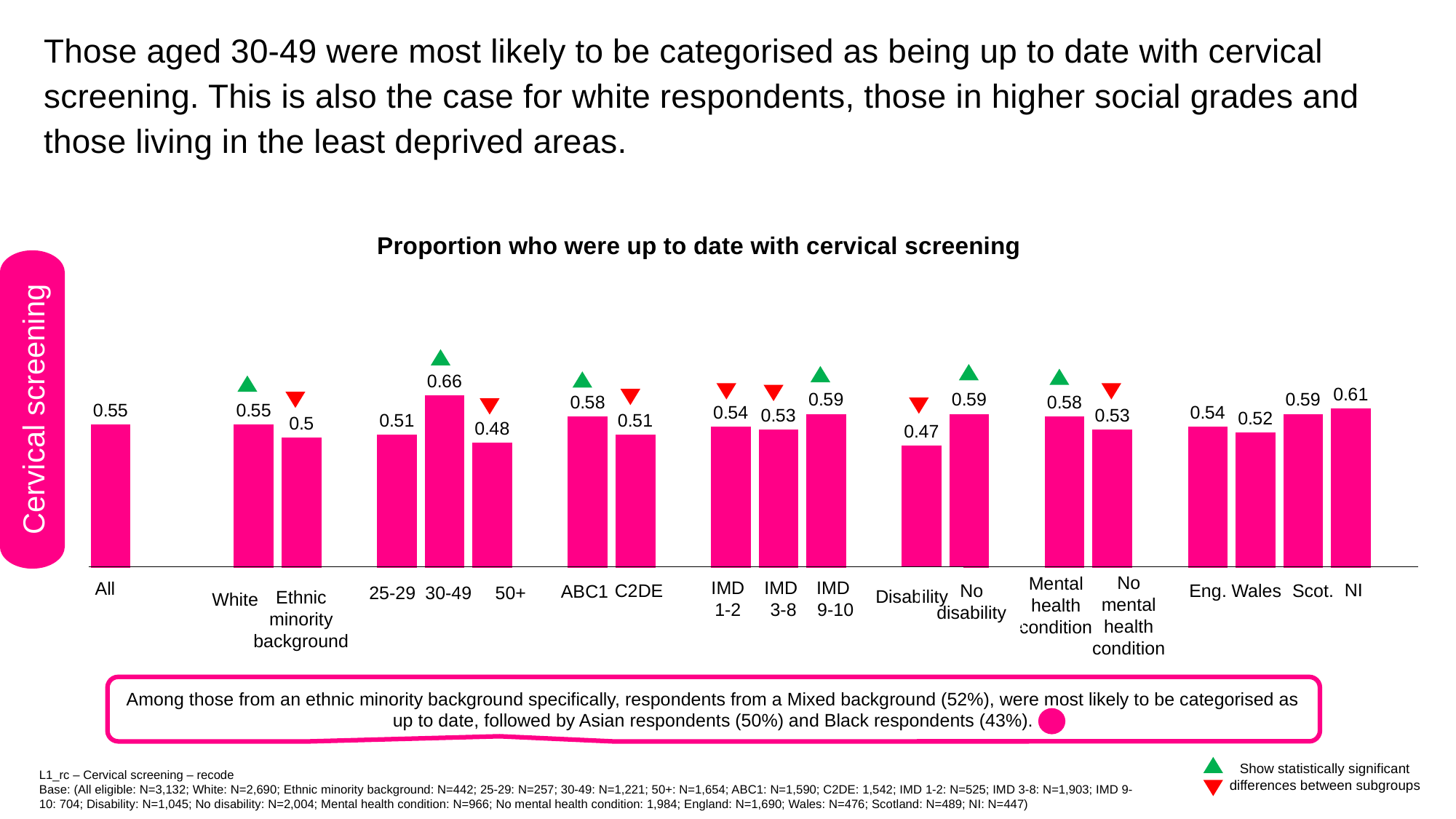
What is the value for respondents with a disability? 0.47 What is the title of the chart? Proportion who were up to date with cervical screening Which category has the highest value? 30-49 What is the value for the 30-49 age group? 0.66 What is the value for NI? 0.61 Which category has the lowest value? Disability What is the difference between the values for 30-49 and 50+? 0.18 What is the difference between the values for ABC1 and C2DE? 0.07 Which has the larger value, Wales or Scot.? Scot. Which has the larger value, IMD 1-2 or IMD 9-10? IMD 9-10 How many bars are plotted in the chart? 19 What is the value for the Ethnic minority background group? 0.5